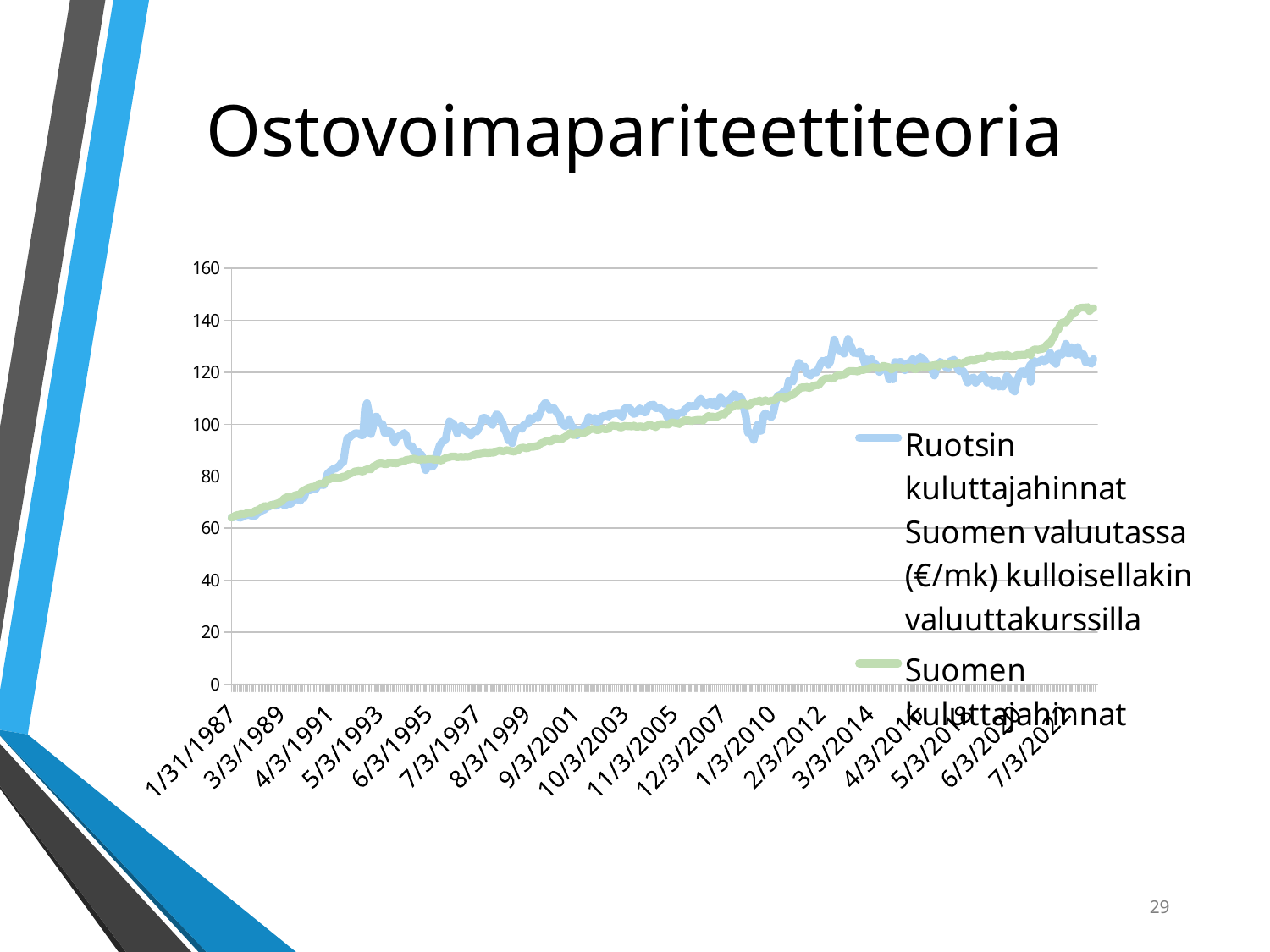
What is the highest value shown on the chart's vertical axis? 160 Do the values of the Suomen kuluttajahinnat series generally rise or fall along the x axis? rise At the right end of the chart, which series has the higher value: Ruotsin kuluttajahinnat or Suomen kuluttajahinnat? Suomen kuluttajahinnat Which series is drawn in green in the chart? Suomen kuluttajahinnat How many series does the chart's legend list? 2 Is the value of the Ruotsin kuluttajahinnat series at the start of the chart (1/31/1987) greater or less than 80? less Around 5/3/1993, which series has the higher value: Ruotsin kuluttajahinnat or Suomen kuluttajahinnat? Ruotsin kuluttajahinnat What is the title of the slide containing the chart? Ostovoimapariteettiteoria Is the value of the Suomen kuluttajahinnat series at the start of the chart (1/31/1987) greater or less than 80? less Is the value of the Ruotsin kuluttajahinnat series around 2/3/2012 greater or less than 120? greater What kind of chart is shown on the slide? line chart